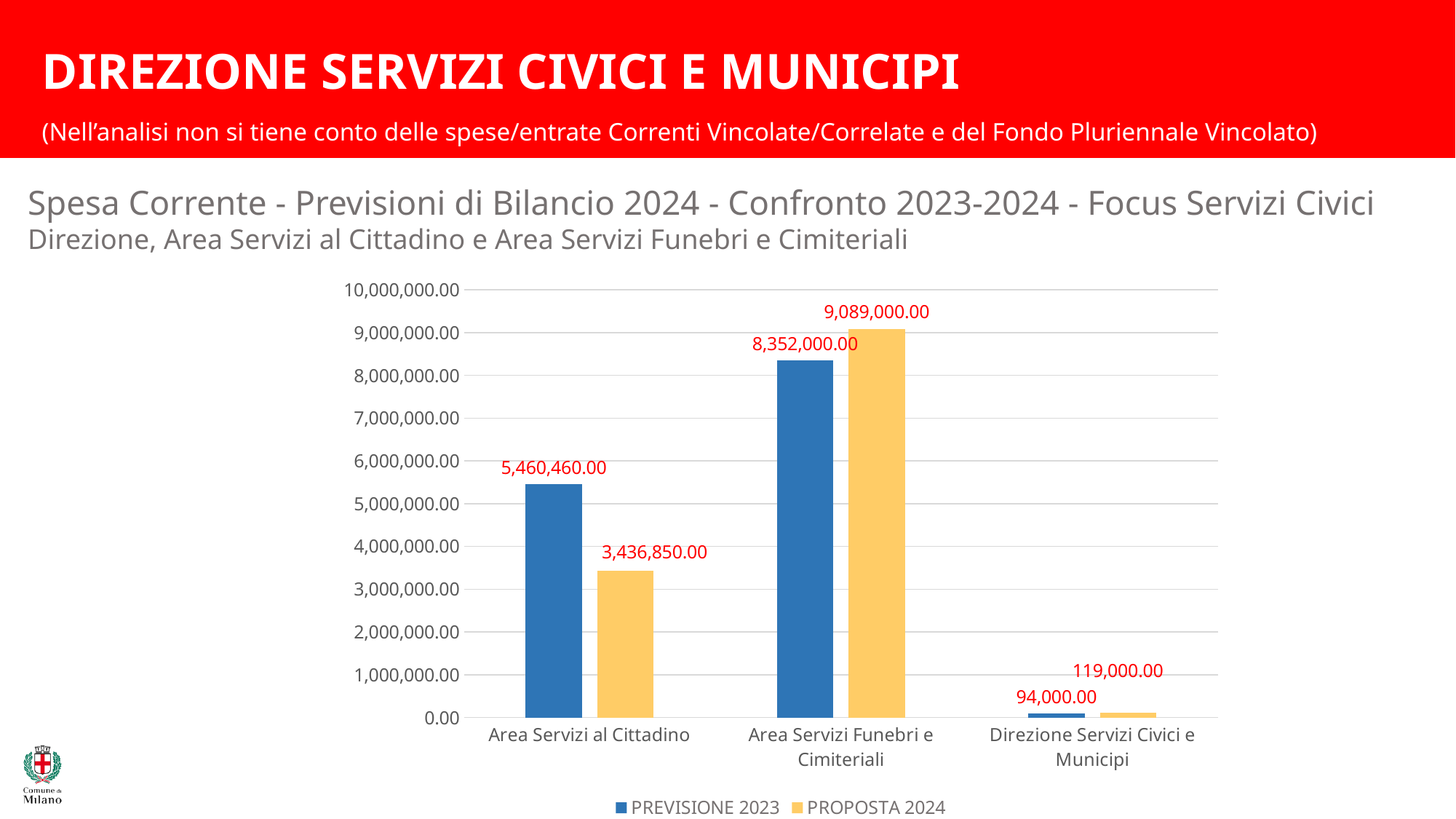
What kind of chart is shown on the slide? Bar chart What is the PROPOSTA 2024 value for Area Servizi Funebri e Cimiteriali? 9,089,000.00 What is the PROPOSTA 2024 value for Area Servizi al Cittadino? 3,436,850.00 Which category has the highest PROPOSTA 2024 value? Area Servizi Funebri e Cimiteriali For Direzione Servizi Civici e Municipi, which is larger: PREVISIONE 2023 or PROPOSTA 2024? PROPOSTA 2024 Which category has the lowest PREVISIONE 2023 value? Direzione Servizi Civici e Municipi What is the difference between the PROPOSTA 2024 and PREVISIONE 2023 values for Area Servizi Funebri e Cimiteriali? 737,000.00 What is the difference between the PREVISIONE 2023 and PROPOSTA 2024 values for Area Servizi al Cittadino? 2,023,610.00 What is the PREVISIONE 2023 value for Area Servizi al Cittadino? 5,460,460.00 How many series does the chart legend list? 2 How many categories are shown on the x axis of the chart? 3 What is the PREVISIONE 2023 value for Direzione Servizi Civici e Municipi? 94,000.00